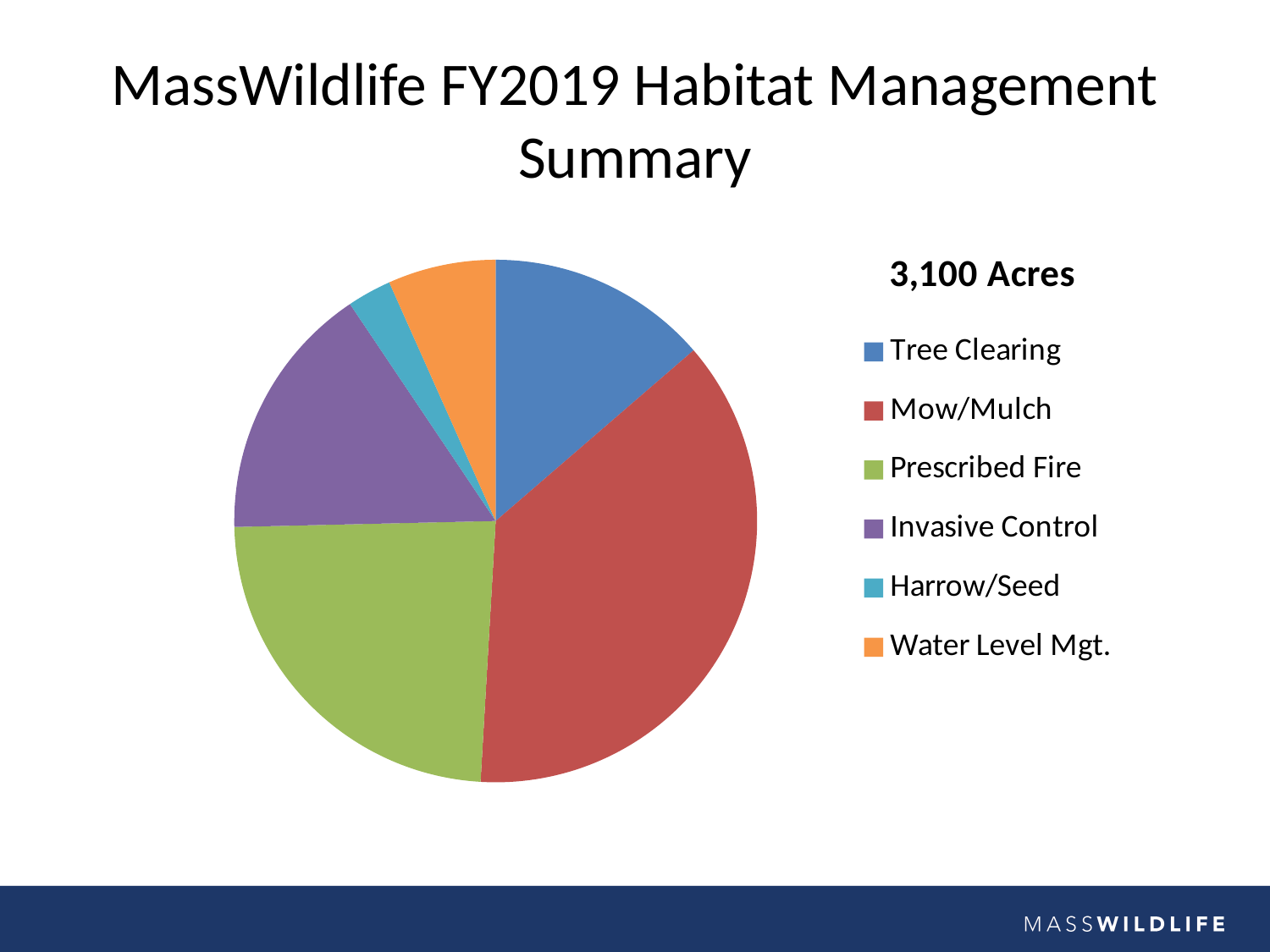
What kind of chart is shown on the slide? pie chart How many categories does the pie chart show? 6 Which slice is larger, Tree Clearing or Water Level Mgt.? Tree Clearing Which slice is larger, Invasive Control or Harrow/Seed? Invasive Control What colour is the Mow/Mulch slice in the pie chart? red Which slice is larger, Mow/Mulch or Tree Clearing? Mow/Mulch What is the title shown above the pie chart's legend? 3,100 Acres Which category has the largest slice of the pie chart? Mow/Mulch Which category has the smallest slice of the pie chart? Harrow/Seed